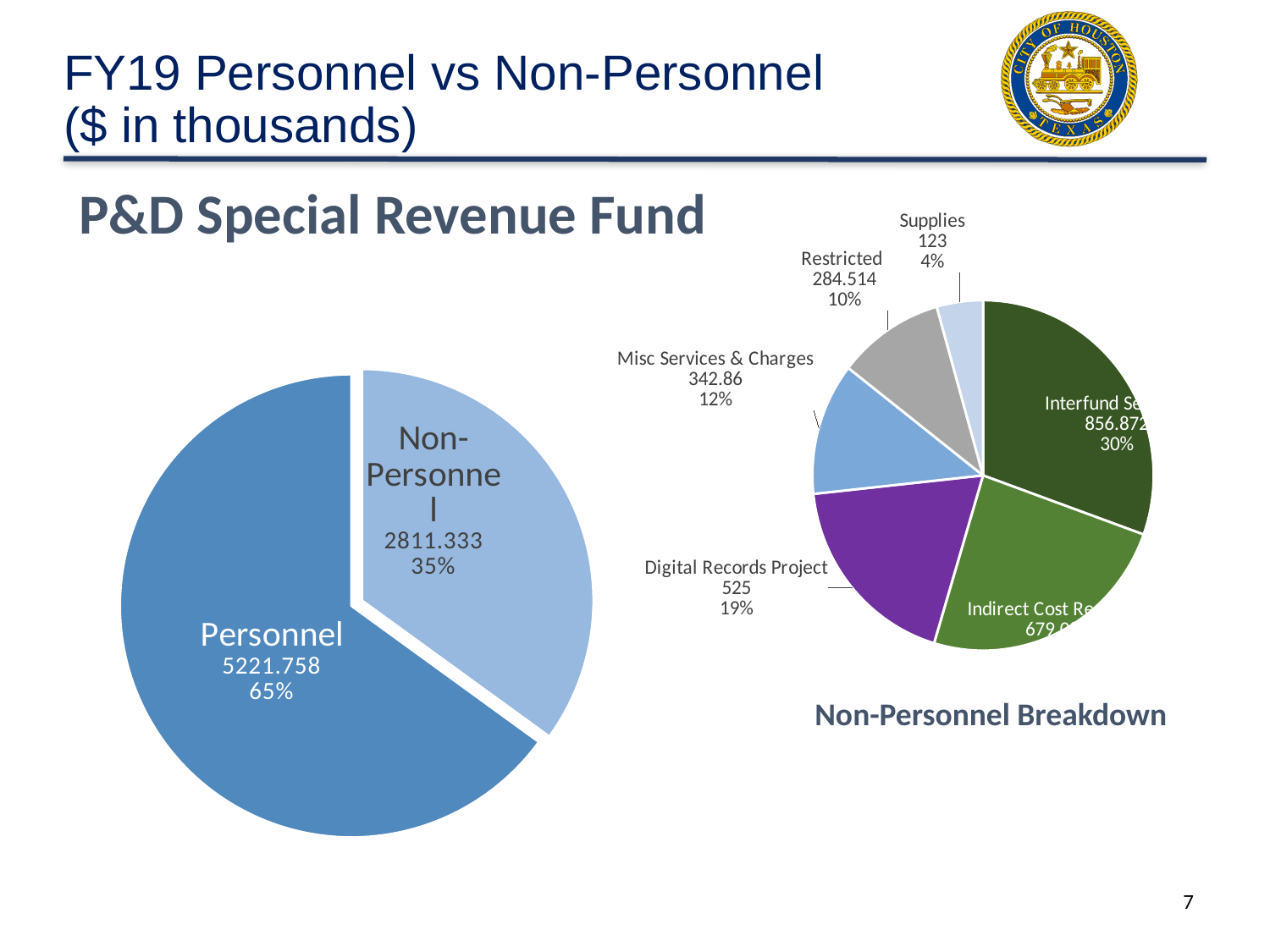
How many slices does the Non-Personnel Breakdown chart have? 6 On the P&D Special Revenue Fund chart, what is the value for Personnel? 5221.758 On the Non-Personnel Breakdown chart, what share of the pie is Misc Services & Charges? 12% On the P&D Special Revenue Fund chart, what is the difference between Personnel and Non-Personnel? 2410.425 What kind of chart is the P&D Special Revenue Fund chart? Pie chart On the P&D Special Revenue Fund chart, which category is the largest? Personnel On the Non-Personnel Breakdown chart, which is larger, Digital Records Project or Restricted? Digital Records Project On the Non-Personnel Breakdown chart, which category is the smallest? Supplies On the P&D Special Revenue Fund chart, what share of the pie is Personnel? 65% On the Non-Personnel Breakdown chart, what is the value for Digital Records Project? 525 On the P&D Special Revenue Fund chart, what is the value for Non-Personnel? 2811.333 On the Non-Personnel Breakdown chart, what is the value for Restricted? 284.514